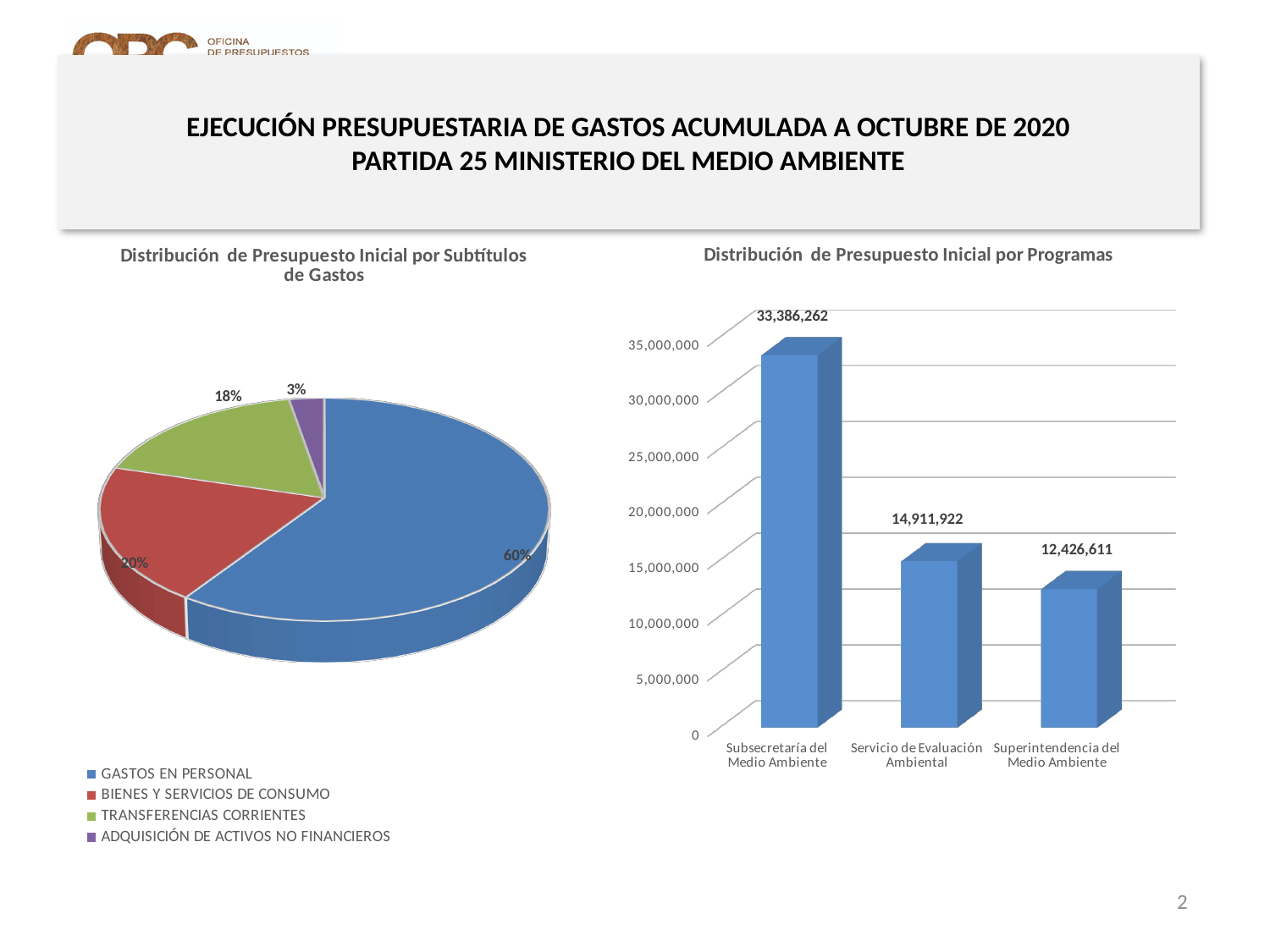
What kind of chart is 'Distribución de Presupuesto Inicial por Programas'? Bar chart In the chart 'Distribución de Presupuesto Inicial por Programas', which program has the highest value? Subsecretaría del Medio Ambiente In the chart 'Distribución de Presupuesto Inicial por Programas', what is the difference between the values for Servicio de Evaluación Ambiental and Superintendencia del Medio Ambiente? 2,485,311 In the chart 'Distribución de Presupuesto Inicial por Programas', what is the value for Servicio de Evaluación Ambiental? 14,911,922 In the chart 'Distribución de Presupuesto Inicial por Programas', what is the value for Superintendencia del Medio Ambiente? 12,426,611 In the pie chart 'Distribución de Presupuesto Inicial por Subtítulos de Gastos', what share does GASTOS EN PERSONAL have? 60% In the chart 'Distribución de Presupuesto Inicial por Programas', how many programs are shown? 3 In the chart 'Distribución de Presupuesto Inicial por Programas', which program has the lowest value? Superintendencia del Medio Ambiente In the pie chart 'Distribución de Presupuesto Inicial por Subtítulos de Gastos', which category has the smallest share? ADQUISICIÓN DE ACTIVOS NO FINANCIEROS In the pie chart 'Distribución de Presupuesto Inicial por Subtítulos de Gastos', what share does TRANSFERENCIAS CORRIENTES have? 18% How many categories does the legend of the pie chart 'Distribución de Presupuesto Inicial por Subtítulos de Gastos' list? 4 In the chart 'Distribución de Presupuesto Inicial por Programas', what is the value for Subsecretaría del Medio Ambiente? 33,386,262